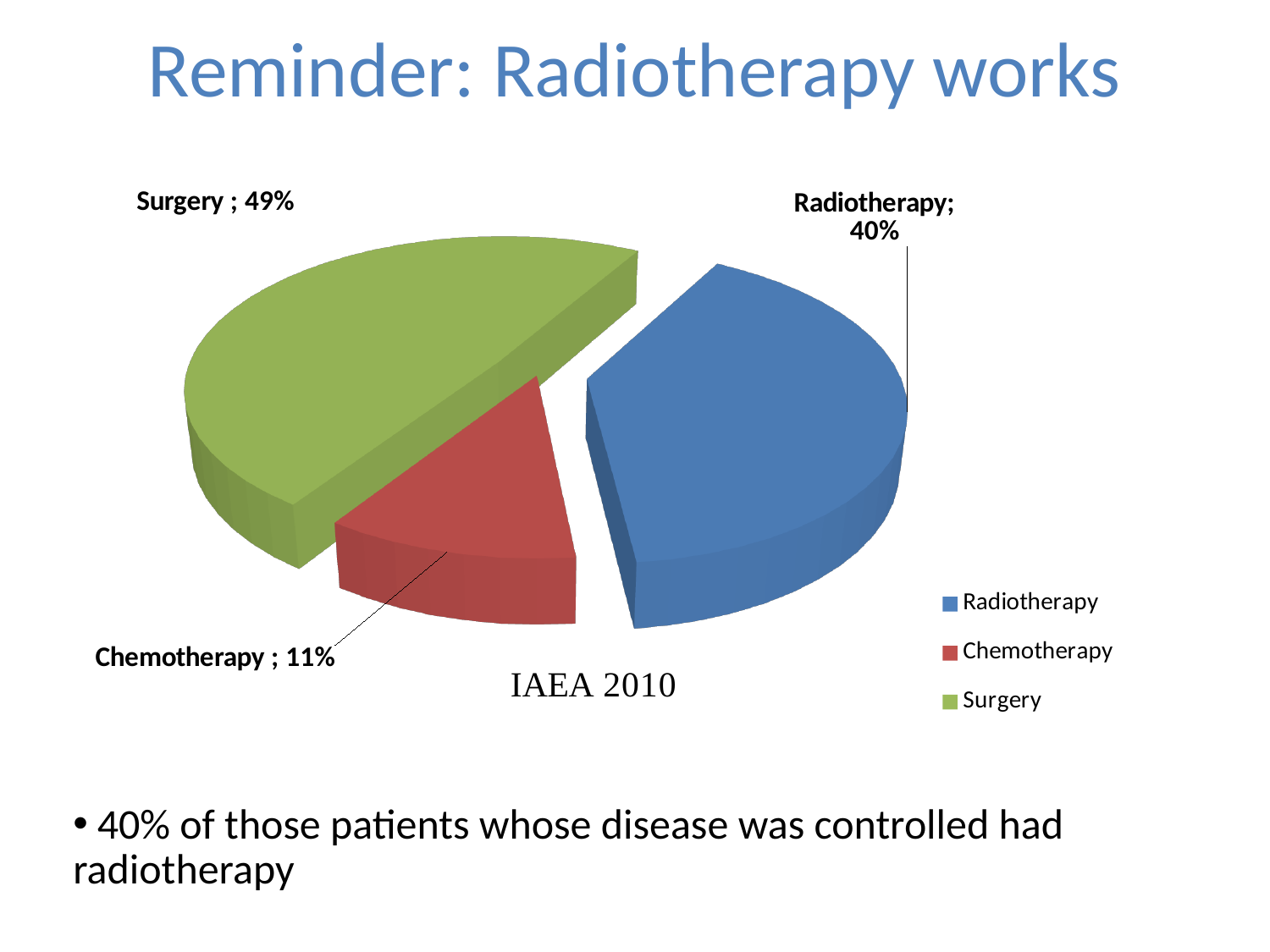
What is the difference in percentage points between Radiotherapy and Chemotherapy? 29 Which category has the largest slice of the pie? Surgery What kind of chart is shown on the slide? Pie chart What colour is the Surgery slice? Green Which is larger, the Radiotherapy slice or the Chemotherapy slice? Radiotherapy What percentage of the pie is Chemotherapy? 11% What percentage of the pie is Radiotherapy? 40% Which category has the smallest slice of the pie? Chemotherapy How many entries does the legend list? 3 How many slices does the pie chart have? 3 What percentage of the pie is Surgery? 49% What is the difference in percentage points between Surgery and Radiotherapy? 9